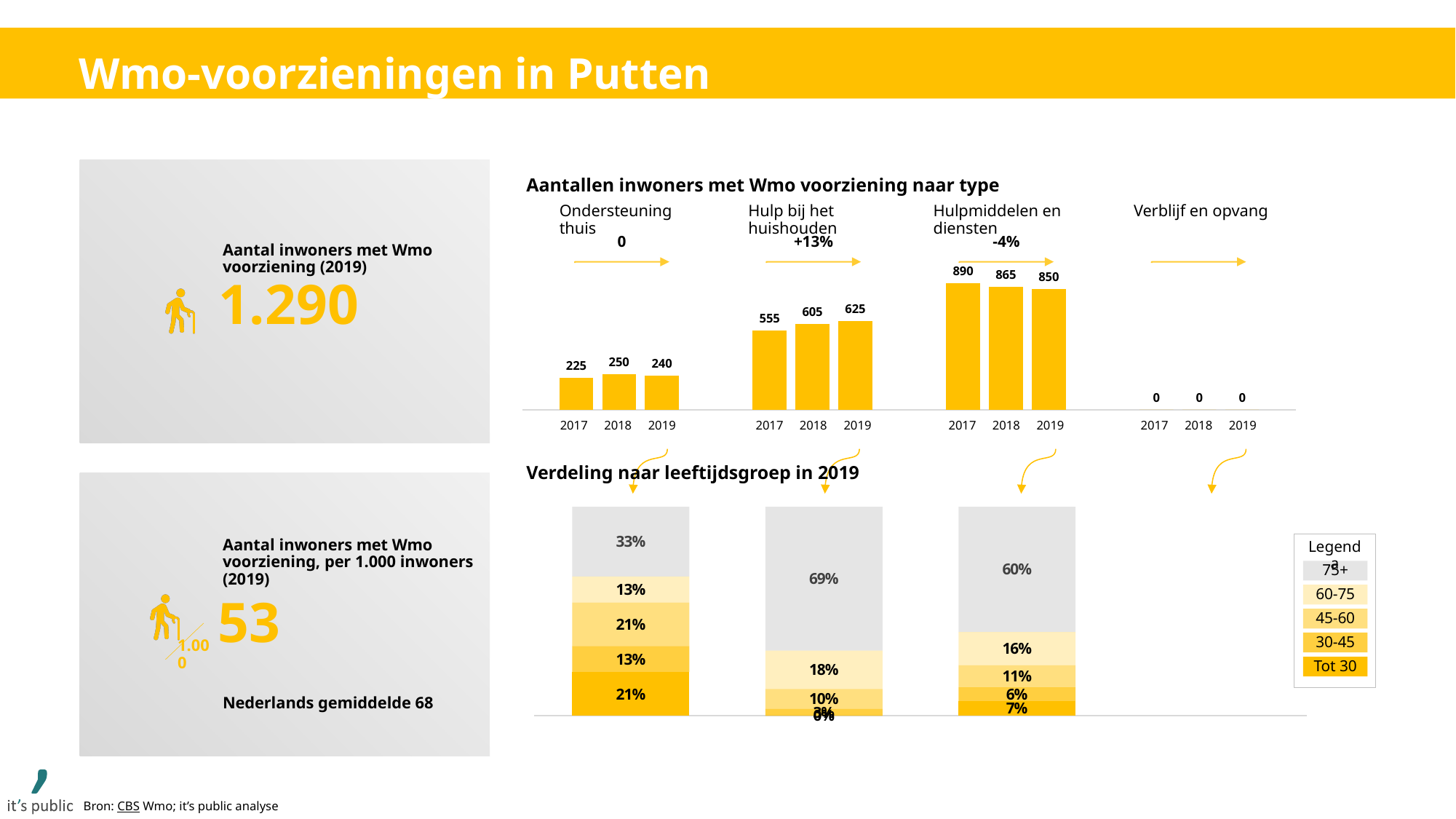
In the chart 'Verdeling naar leeftijdsgroep in 2019', what is the share of the 75+ group in the leftmost stacked bar? 33% In the chart 'Aantallen inwoners met Wmo voorziening naar type', what percentage change is shown above the Hulp bij het huishouden bars? +13% How many age groups does the legend of the chart 'Verdeling naar leeftijdsgroep in 2019' list? 5 In the chart 'Aantallen inwoners met Wmo voorziening naar type', what is the difference between the 2019 and 2017 values for Hulp bij het huishouden? 70 In the chart 'Aantallen inwoners met Wmo voorziening naar type', what is the value for Hulpmiddelen en diensten in 2017? 890 In the chart 'Aantallen inwoners met Wmo voorziening naar type', do the values for Hulpmiddelen en diensten rise or fall from 2017 to 2019? fall In the chart 'Aantallen inwoners met Wmo voorziening naar type', what is the value for Hulp bij het huishouden in 2019? 625 In the chart 'Aantallen inwoners met Wmo voorziening naar type', which year has the larger value for Ondersteuning thuis, 2018 or 2019? 2018 In the chart 'Aantallen inwoners met Wmo voorziening naar type', how many years are shown for each type? 3 In the chart 'Aantallen inwoners met Wmo voorziening naar type', which type has the highest value in 2019? Hulpmiddelen en diensten What kind of chart is 'Aantallen inwoners met Wmo voorziening naar type'? bar chart In the chart 'Verdeling naar leeftijdsgroep in 2019', what is the share of the 75+ group in the third stacked bar from the left? 60%